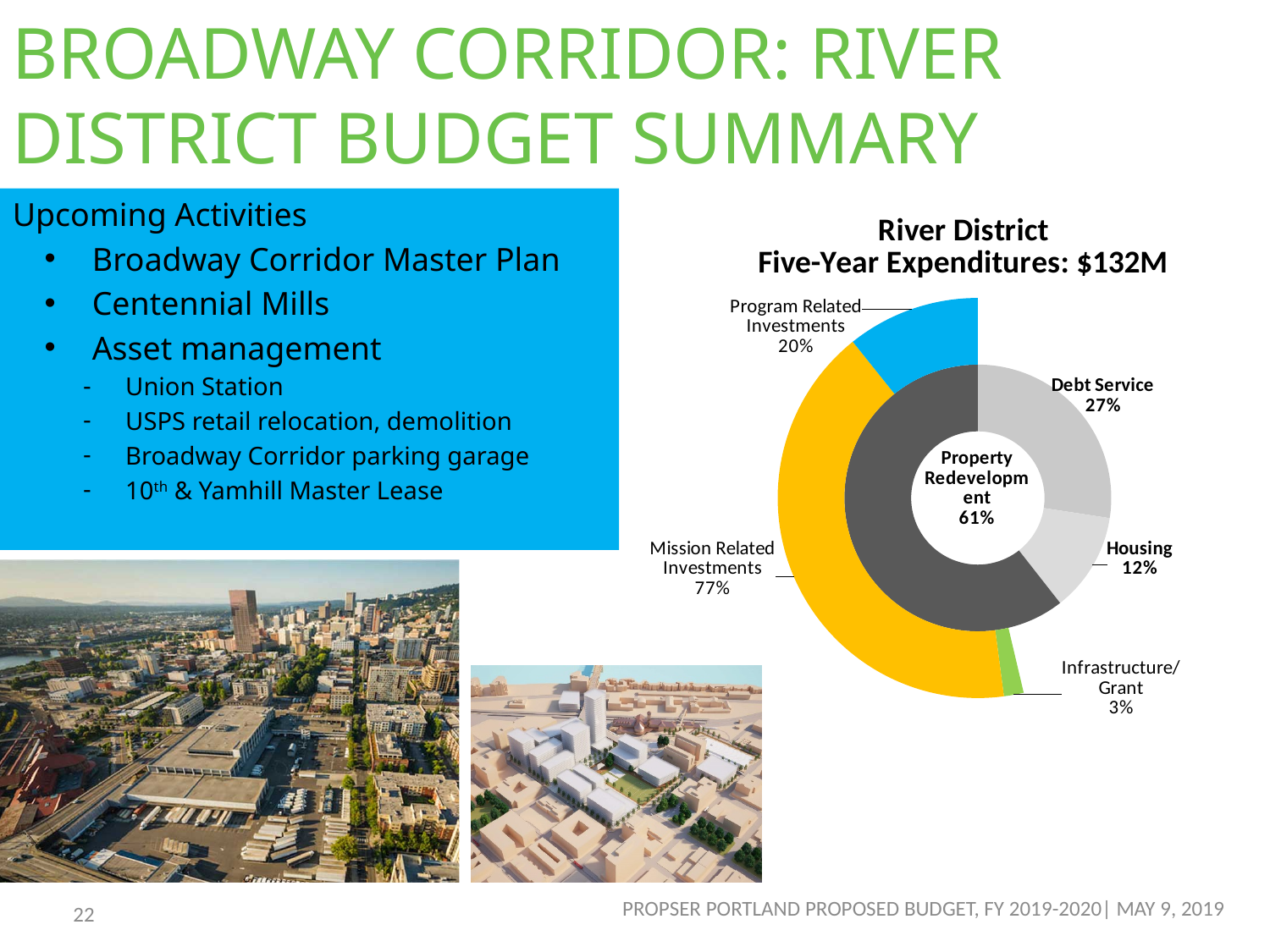
What kind of chart is shown on the slide? Doughnut chart What share of the inner ring is Debt Service? 27% What is the title of the chart? River District Five-Year Expenditures: $132M What is the difference in percentage points between Debt Service and Housing? 15 What share of the inner ring is Housing? 12% Which category in the inner ring has the largest share? Property Redevelopment What share of the outer ring is Program Related Investments? 20% Which category in the outer ring has the smallest share? Infrastructure/Grant Which is larger, Mission Related Investments or Program Related Investments? Mission Related Investments What share of the outer ring is Infrastructure/Grant? 3% What share of the outer ring is Mission Related Investments? 77% What share of the inner ring is Property Redevelopment? 61%